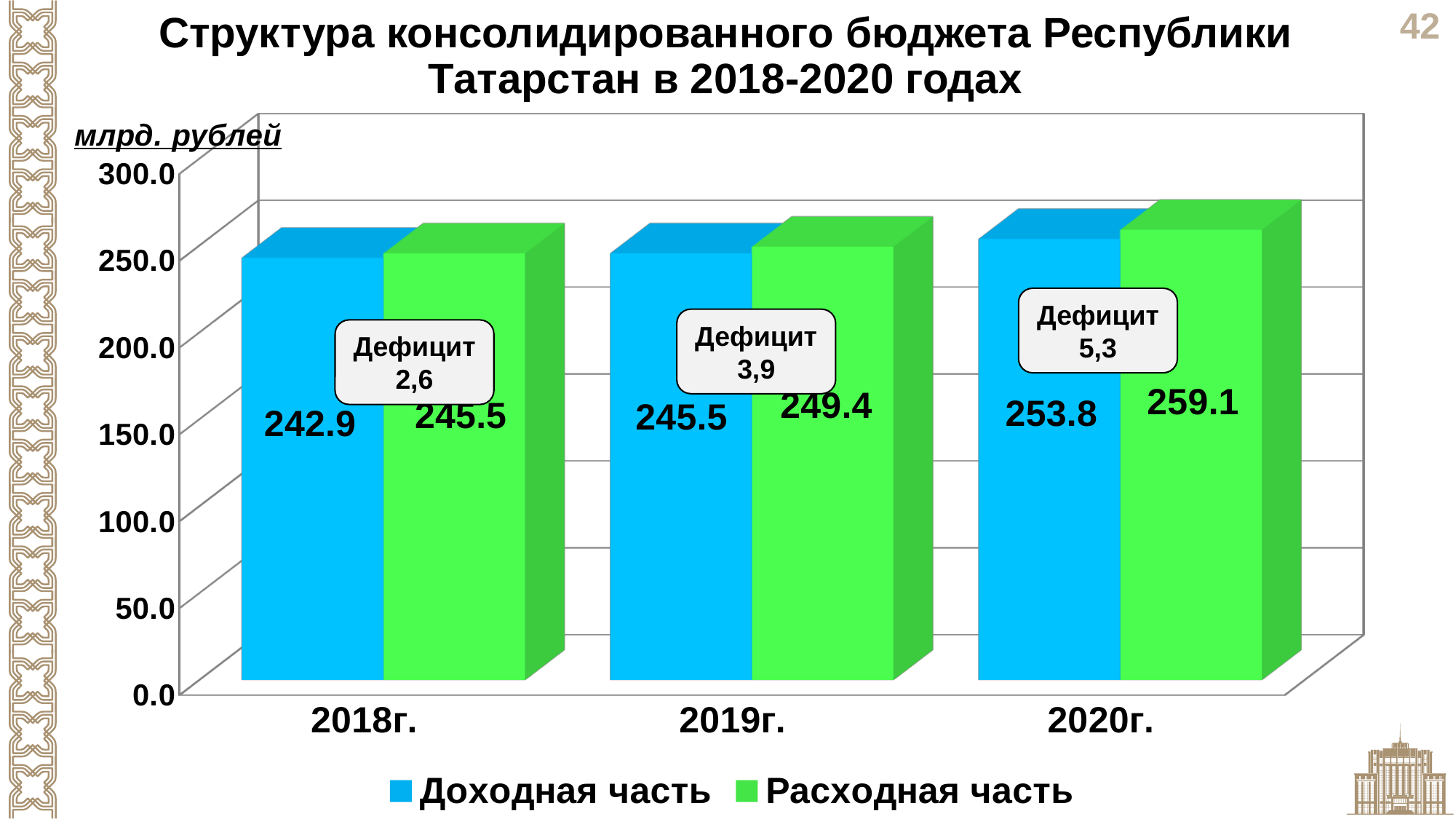
Which is larger in 2019г.: Доходная часть or Расходная часть? Расходная часть What kind of chart is shown on the slide? bar chart What is the value of Доходная часть for 2018г.? 242.9 Which year has the highest Расходная часть value? 2020г. What is the value of Расходная часть for 2020г.? 259.1 What is the difference between Расходная часть and Доходная часть in 2020г.? 5.3 Do the Доходная часть values rise or fall from 2018г. to 2020г.? rise What is the value of Расходная часть for 2019г.? 249.4 Which year has the lowest Доходная часть value? 2018г. How many series does the legend list? 2 How many years are shown on the x axis? 3 What is the difference between Доходная часть in 2020г. and Доходная часть in 2018г.? 10.9